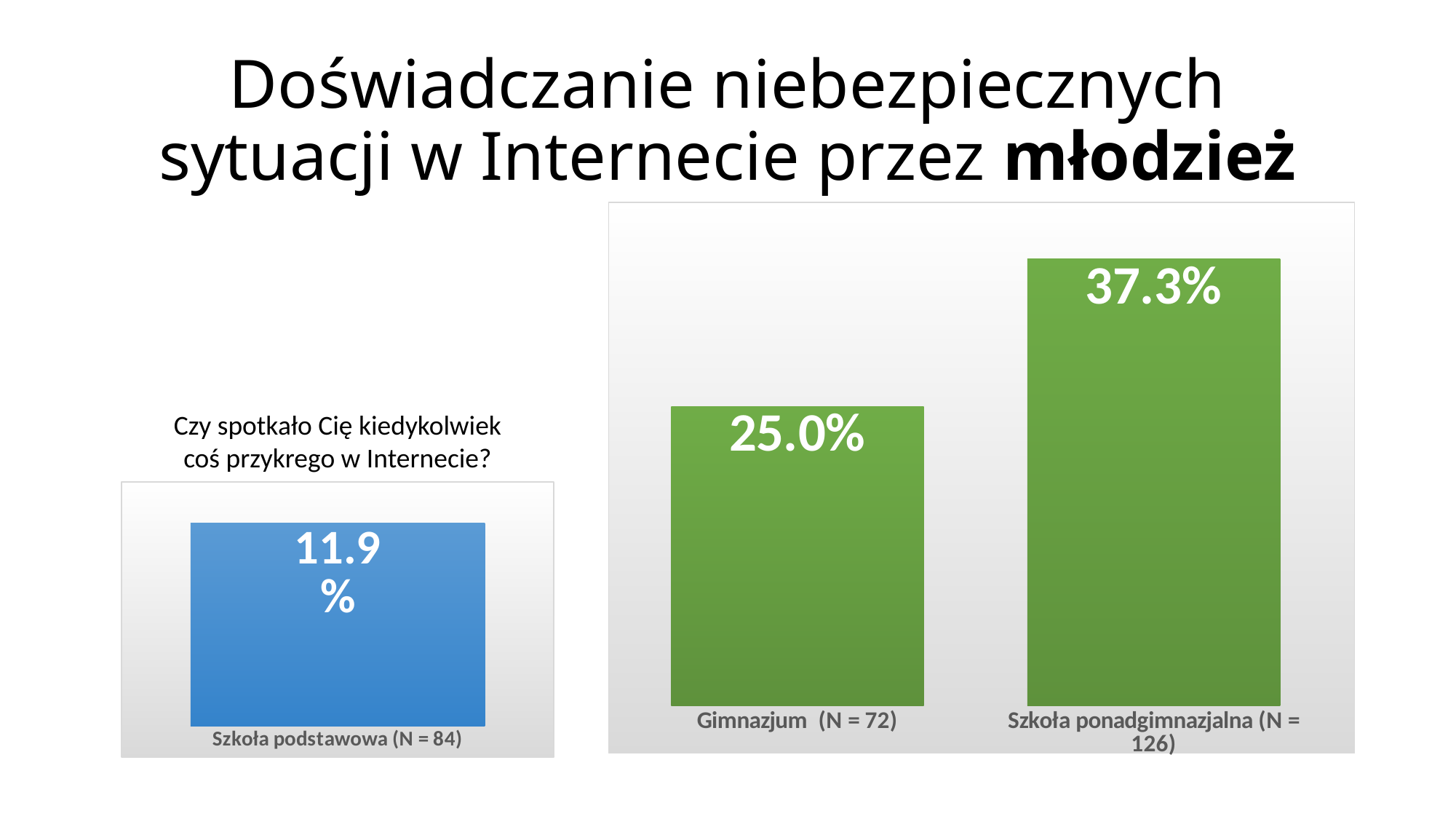
In the chart on the left, what is the value for Szkoła podstawowa (N = 84)? 11.9% In the chart on the right, what is the value for Szkoła ponadgimnazjalna (N = 126)? 37.3% In the chart on the right, do the values rise or fall from left to right? Rise In the chart on the right, which category has the highest value? Szkoła ponadgimnazjalna (N = 126) How many bars are in the chart on the right? 2 In the chart on the right, what is the value for Gimnazjum (N = 72)? 25.0% In the chart on the right, which category has the lowest value? Gimnazjum (N = 72) In the chart on the right, what is the difference between the values for Szkoła ponadgimnazjalna and Gimnazjum? 12.3% How many bars are in the chart on the left? 1 What kind of chart is the chart on the right? Bar chart What colour is the bar in the chart on the left? Blue In the chart on the right, which is larger: the value for Gimnazjum or for Szkoła ponadgimnazjalna? Szkoła ponadgimnazjalna